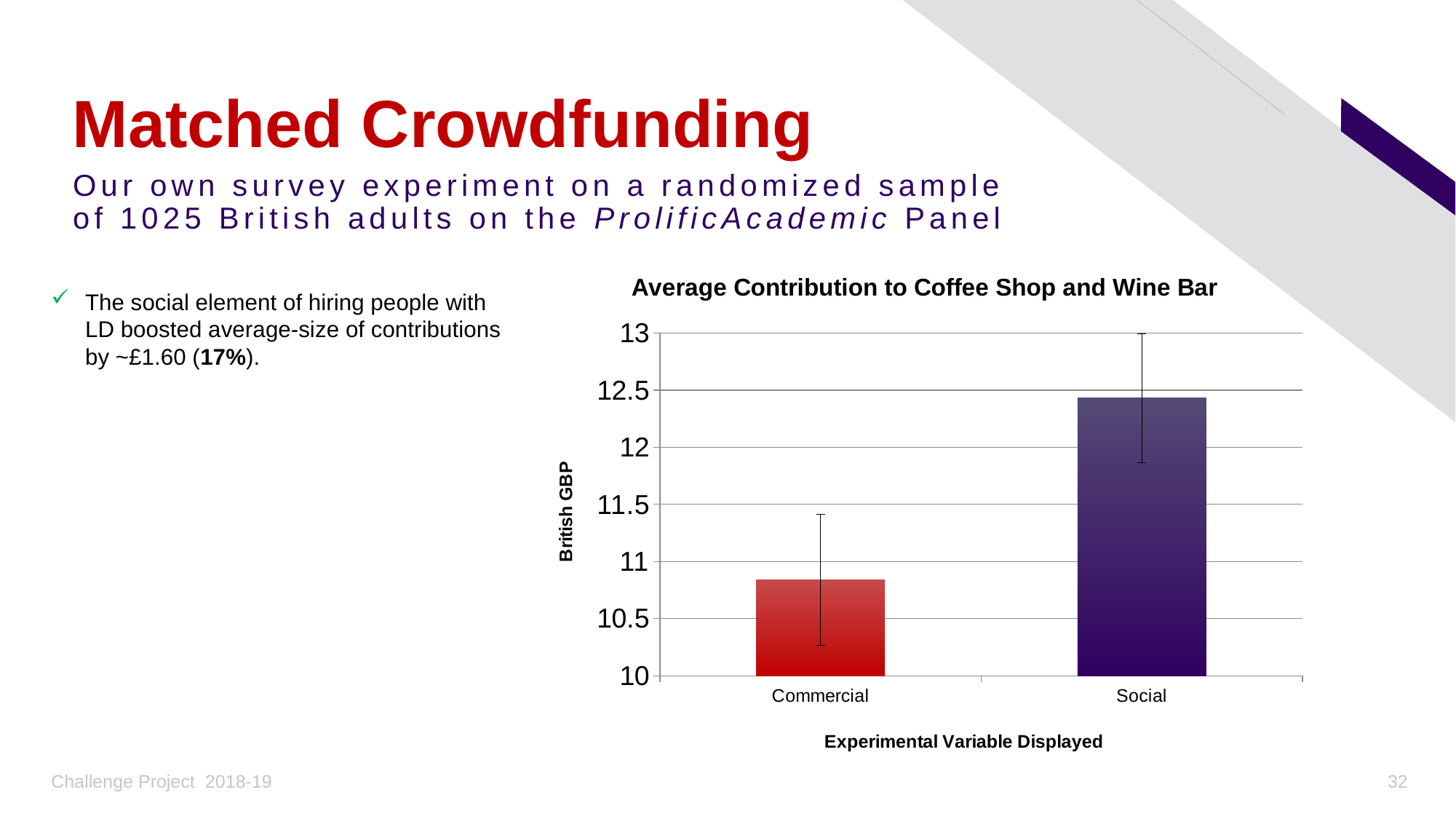
What kind of chart is shown on the slide? bar chart Is the value for Commercial greater or less than 10.5? greater Do the values rise or fall from Commercial to Social along the x axis? rise Which category has the lowest average contribution? Commercial How many categories are shown on the x axis of the chart? 2 Is the value for Commercial greater or less than 11? less Is the value for Social greater or less than 12? greater What is the title of the chart? Average Contribution to Coffee Shop and Wine Bar What is the label of the y axis? British GBP Which is larger, the value for Commercial or the value for Social? Social Which category has the highest average contribution? Social